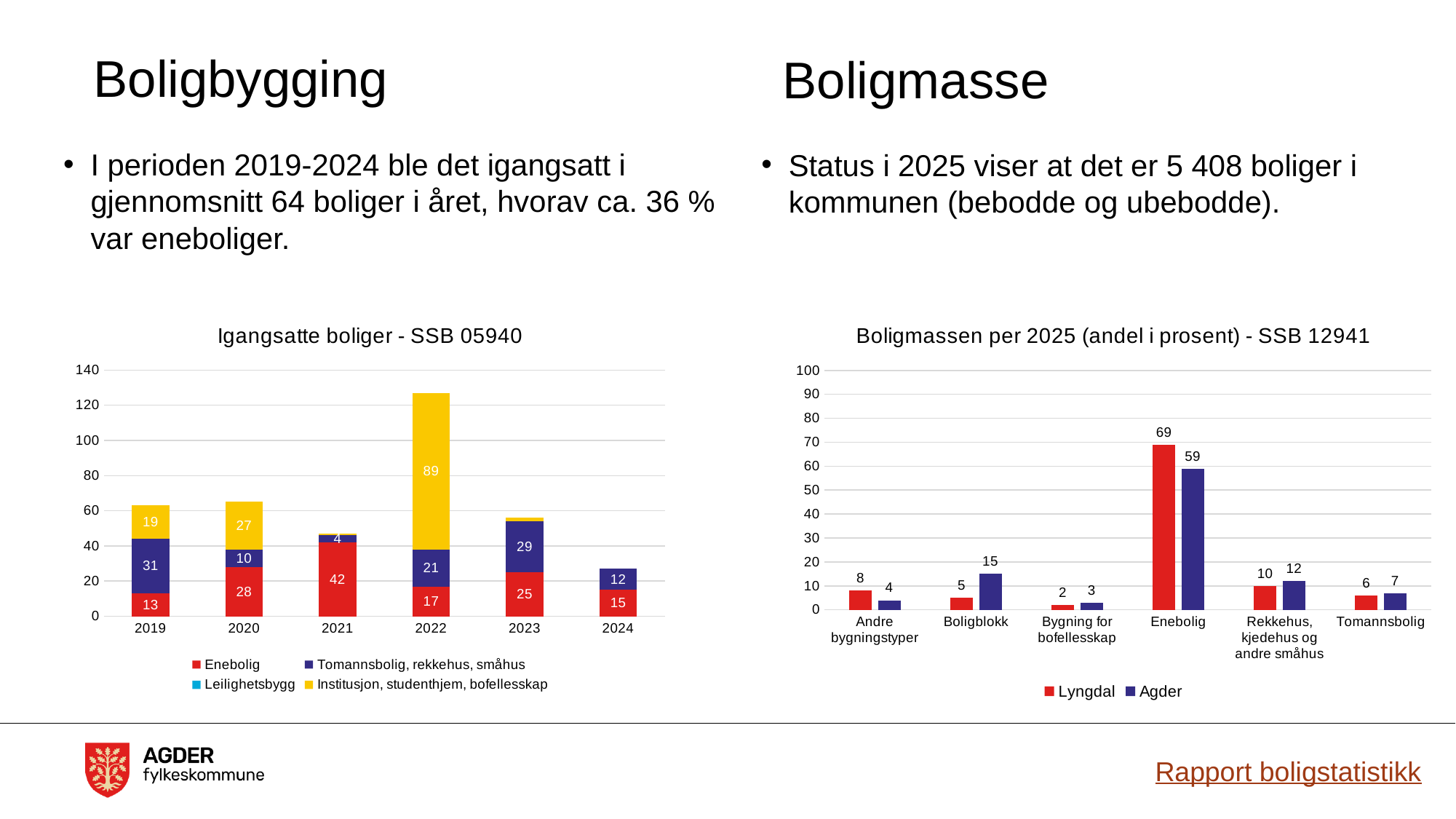
In the chart 'Igangsatte boliger - SSB 05940', how many series does the legend list? 4 In the chart 'Boligmassen per 2025 (andel i prosent) - SSB 12941', what is the value for Lyngdal in the Enebolig category? 69 In the chart 'Boligmassen per 2025 (andel i prosent) - SSB 12941', how many categories are shown on the x axis? 6 In the chart 'Igangsatte boliger - SSB 05940', what is the value for Enebolig in 2021? 42 In the chart 'Boligmassen per 2025 (andel i prosent) - SSB 12941', which category has the lowest value for Lyngdal? Bygning for bofellesskap In the chart 'Boligmassen per 2025 (andel i prosent) - SSB 12941', which is larger for Rekkehus, kjedehus og andre småhus: Lyngdal or Agder? Agder What type of chart is 'Boligmassen per 2025 (andel i prosent) - SSB 12941'? Bar chart In the chart 'Igangsatte boliger - SSB 05940', what is the value for Institusjon, studenthjem, bofellesskap in 2022? 89 In the chart 'Boligmassen per 2025 (andel i prosent) - SSB 12941', what is the difference between Agder and Lyngdal for Boligblokk? 10 In the chart 'Igangsatte boliger - SSB 05940', which year has the highest total stacked bar? 2022 In the chart 'Igangsatte boliger - SSB 05940', what is the total of the stacked bar for 2019? 63 In the chart 'Igangsatte boliger - SSB 05940', is the total for 2024 greater or less than 40? less